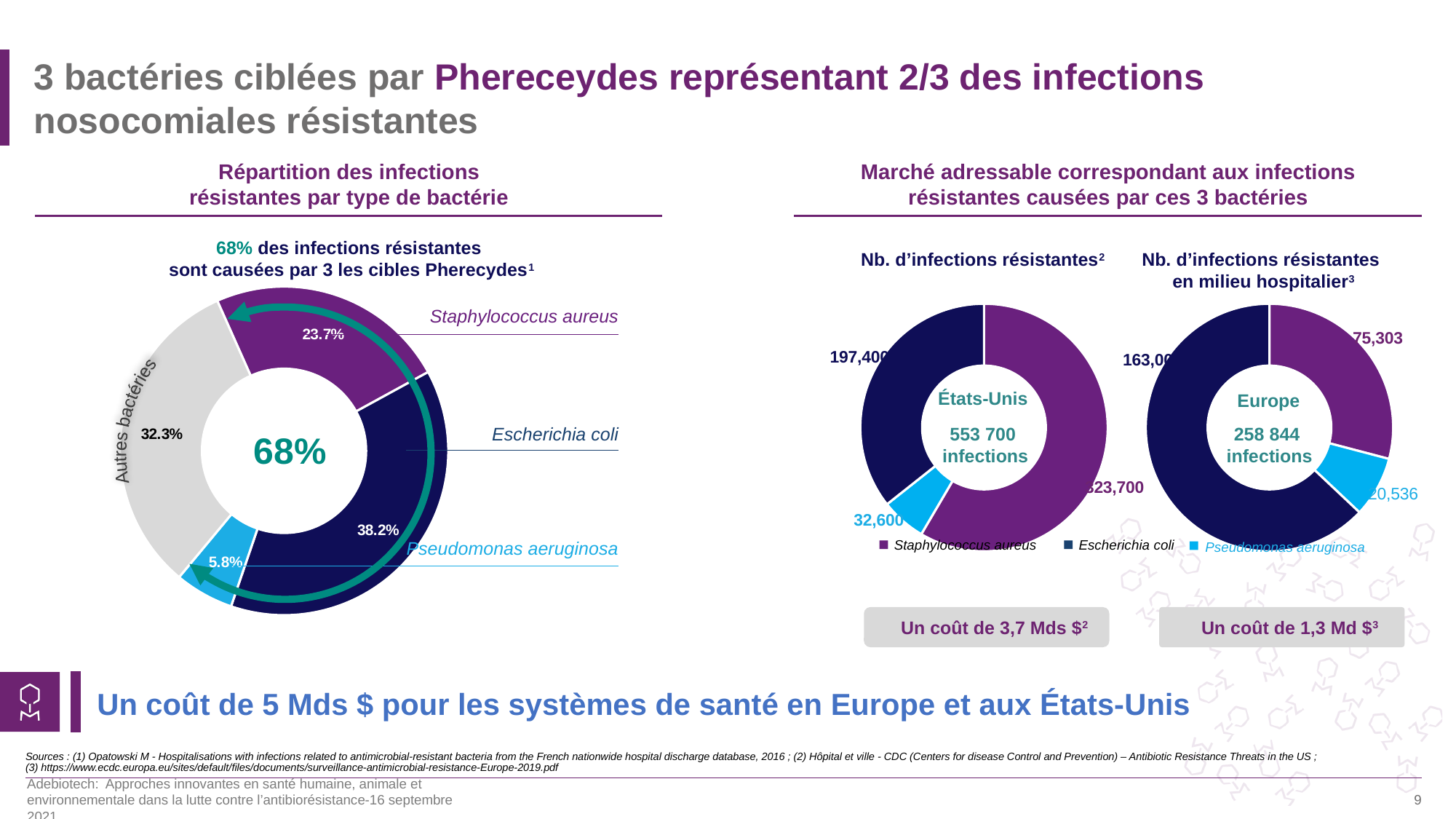
On the 'Europe' donut chart, which bacterium accounts for the largest number of resistant infections? Escherichia coli On the left chart 'Répartition des infections résistantes par type de bactérie', what share is attributed to Staphylococcus aureus? 23.7% On the left chart 'Répartition des infections résistantes par type de bactérie', what is the difference between the Escherichia coli share and the Staphylococcus aureus share? 14.5% How many series does the legend under the 'États-Unis' and 'Europe' donut charts list? 3 On the left chart 'Répartition des infections résistantes par type de bactérie', which bacterium among the three Pherecydes targets has the smallest share? Pseudomonas aeruginosa On the 'Europe' donut chart, how many resistant hospital infections are attributed to Staphylococcus aureus? 75,303 On the 'États-Unis' donut chart, how many resistant infections are attributed to Pseudomonas aeruginosa? 32,600 On the left chart 'Répartition des infections résistantes par type de bactérie', how many slices does the donut have? 4 On the 'États-Unis' donut chart, how many resistant infections are attributed to Escherichia coli? 197,400 What kind of chart is used for 'Répartition des infections résistantes par type de bactérie'? Donut (pie) chart On the left chart 'Répartition des infections résistantes par type de bactérie', what share is attributed to Pseudomonas aeruginosa? 5.8% On the left chart 'Répartition des infections résistantes par type de bactérie', what share of resistant infections is caused by Escherichia coli? 38.2%